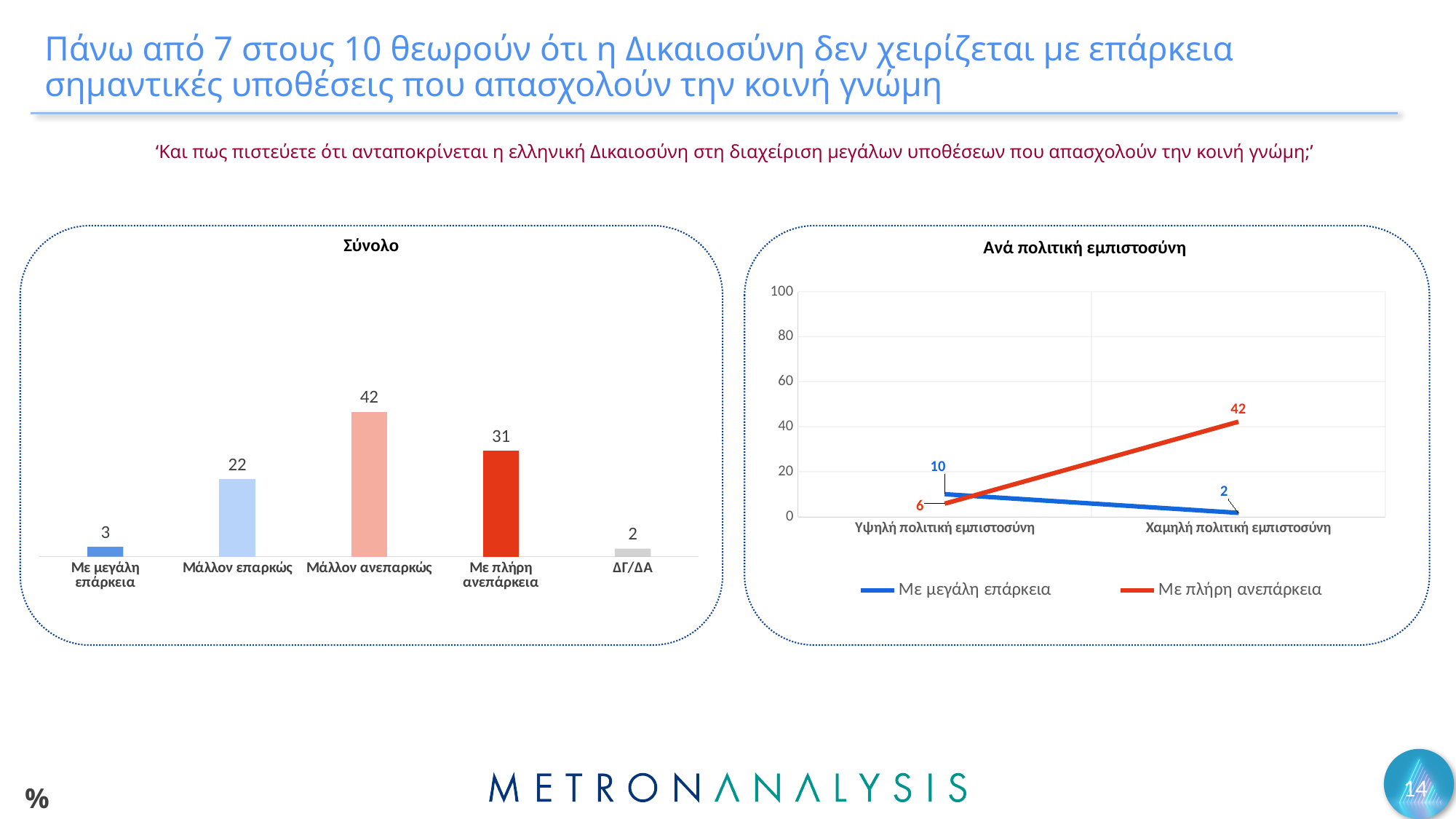
In the 'Σύνολο' chart, what is the value for 'Μάλλον ανεπαρκώς'? 42 In the 'Ανά πολιτική εμπιστοσύνη' chart, what is the value of 'Με μεγάλη επάρκεια' for 'Υψηλή πολιτική εμπιστοσύνη'? 10 In the 'Σύνολο' chart, what is the value for 'Με μεγάλη επάρκεια'? 3 How many categories are shown in the 'Σύνολο' chart? 5 In the 'Σύνολο' chart, which category has the lowest value? ΔΓ/ΔΑ In the 'Ανά πολιτική εμπιστοσύνη' chart, what is the value of 'Με πλήρη ανεπάρκεια' for 'Χαμηλή πολιτική εμπιστοσύνη'? 42 In the 'Σύνολο' chart, which is larger: 'Μάλλον επαρκώς' or 'Με πλήρη ανεπάρκεια'? Με πλήρη ανεπάρκεια In the 'Σύνολο' chart, what is the difference between 'Μάλλον ανεπαρκώς' and 'Με πλήρη ανεπάρκεια'? 11 In the 'Ανά πολιτική εμπιστοσύνη' chart, does the 'Με πλήρη ανεπάρκεια' line rise or fall from 'Υψηλή πολιτική εμπιστοσύνη' to 'Χαμηλή πολιτική εμπιστοσύνη'? Rise In the 'Σύνολο' chart, which category has the highest value? Μάλλον ανεπαρκώς How many series does the legend of the 'Ανά πολιτική εμπιστοσύνη' chart list? 2 What kind of chart is the 'Σύνολο' chart? Bar chart